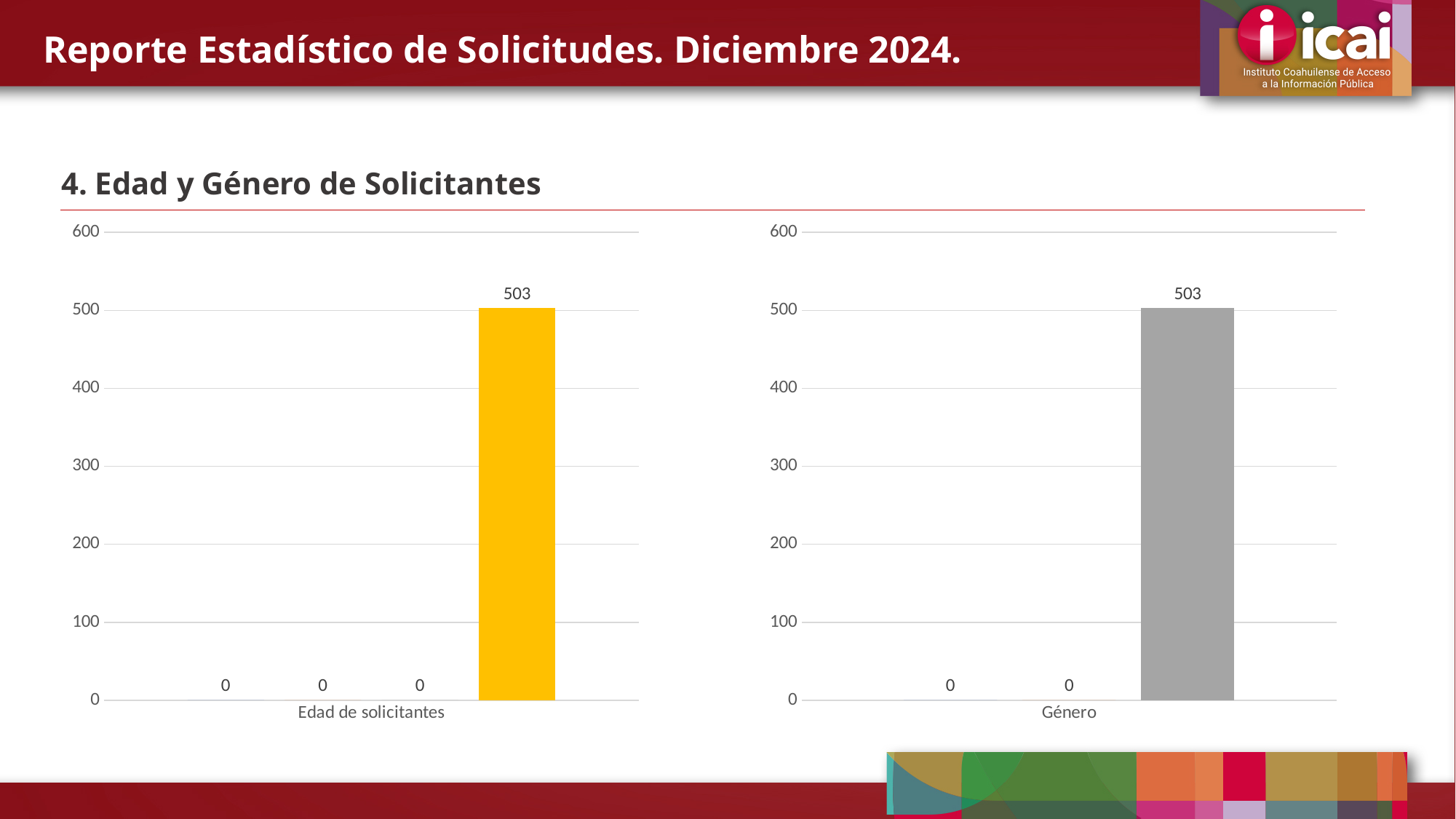
In the right chart (Género), what is the value shown on the tallest bar? 503 What type of chart is the left chart labelled 'Edad de solicitantes'? bar chart In the left chart (Edad de solicitantes), how many of the data labels read 0? 3 What is the highest value shown on the vertical axis of the left chart (Edad de solicitantes)? 600 In the right chart (Género), how many of the data labels read 0? 2 In the right chart (Género), how many data labels are shown above the x axis? 3 In the right chart (Género), is the value of the grey bar greater or less than 600? less What colour is the tallest bar in the right chart (Género)? grey In the left chart (Edad de solicitantes), is the value of the yellow bar greater or less than 500? greater In the left chart (Edad de solicitantes), what is the value shown on the tallest bar? 503 What type of chart is the right chart labelled 'Género'? bar chart